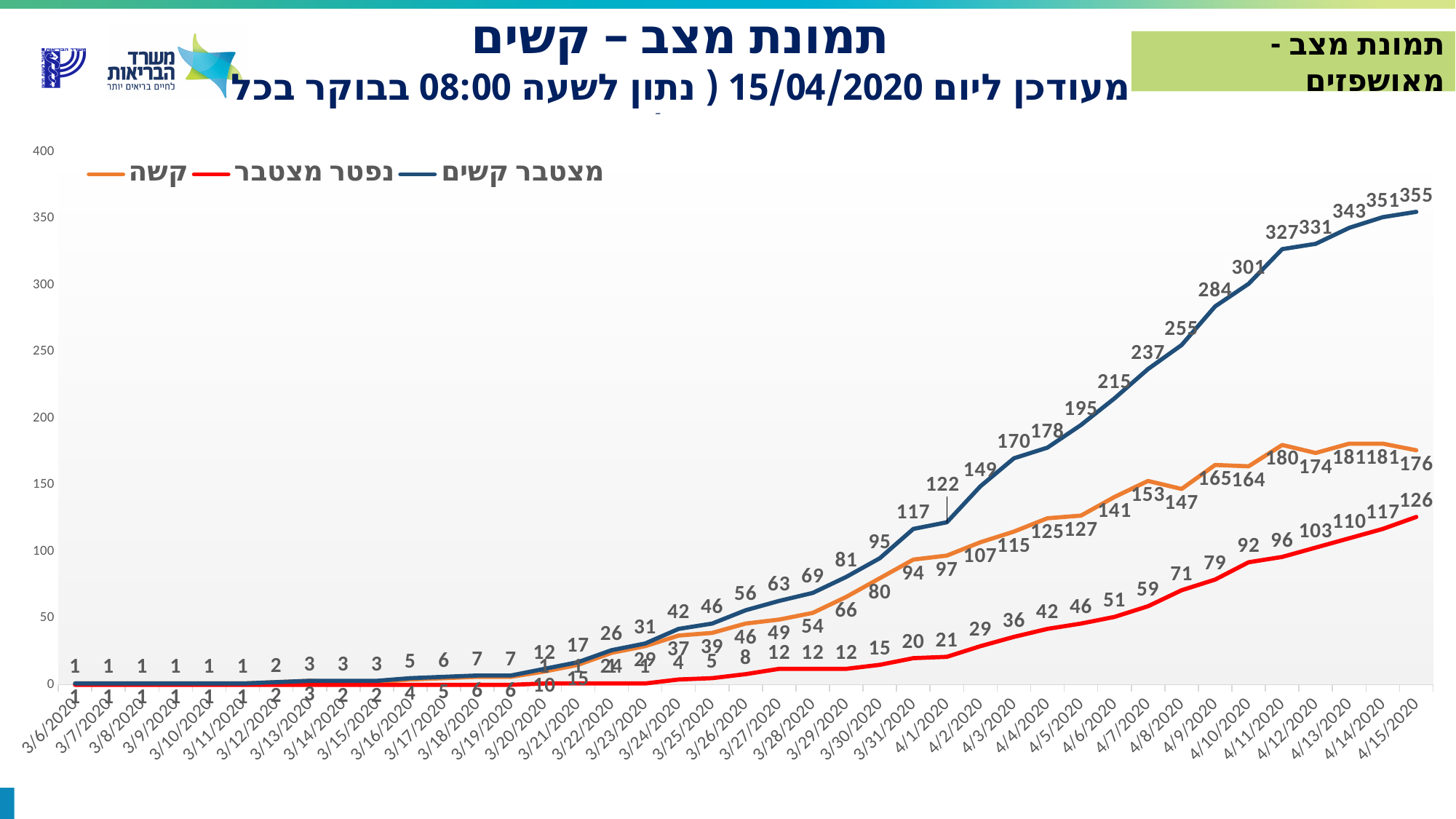
What is the value of the מצטבר קשים series on 4/15/2020? 355 Which is larger on 4/9/2020: the קשה value or the נפטר מצטבר value? קשה What kind of chart is shown on the slide? Line chart How many series does the legend list? 3 What is the difference between the מצטבר קשים value and the נפטר מצטבר value on 4/15/2020? 229 What is the value of the נפטר מצטבר series on 4/15/2020? 126 What is the difference between the קשה values on 4/14/2020 and 4/15/2020? 5 What is the value of the קשה series on 4/11/2020? 180 Does the מצטבר קשים series rise or fall from 3/6/2020 to 4/15/2020? Rise What colour is the line for the נפטר מצטבר series? Red What is the value of the מצטבר קשים series on 3/31/2020? 117 On which date does the מצטבר קשים series reach its highest value? 4/15/2020